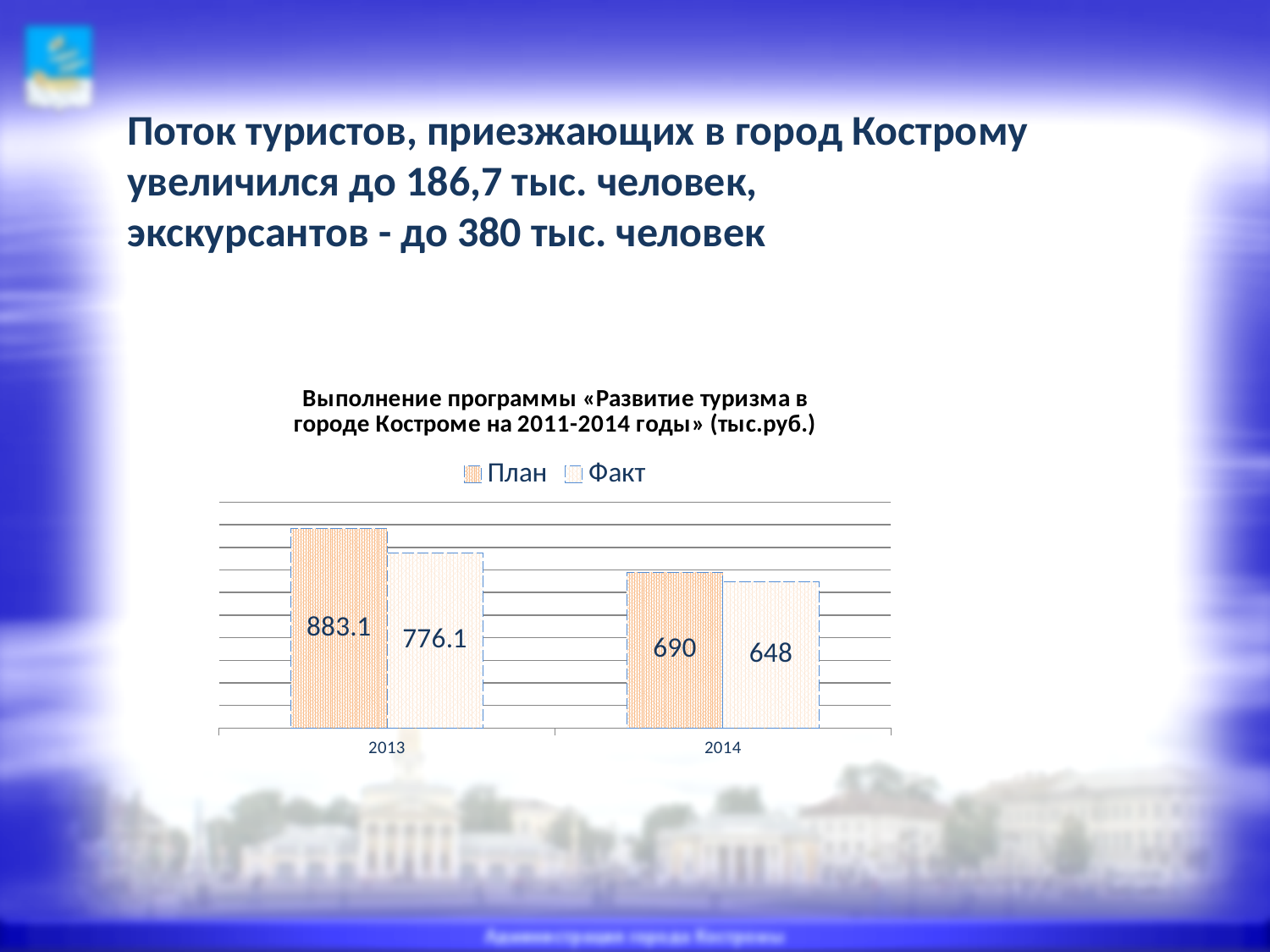
What is the Факт value for 2013? 776.1 Do the Факт values rise or fall from 2013 to 2014? Fall What is the План value for 2013? 883.1 What is the difference between План and Факт in 2014? 42 Which is larger, the Факт value for 2013 or the План value for 2014? Факт 2013 How many series does the legend list? 2 What is the План value for 2014? 690 Which bar has the highest value in the chart? План 2013 What is the difference between План and Факт in 2013? 107 What kind of chart is shown on the slide? Bar chart What is the Факт value for 2014? 648 Which bar has the lowest value in the chart? Факт 2014